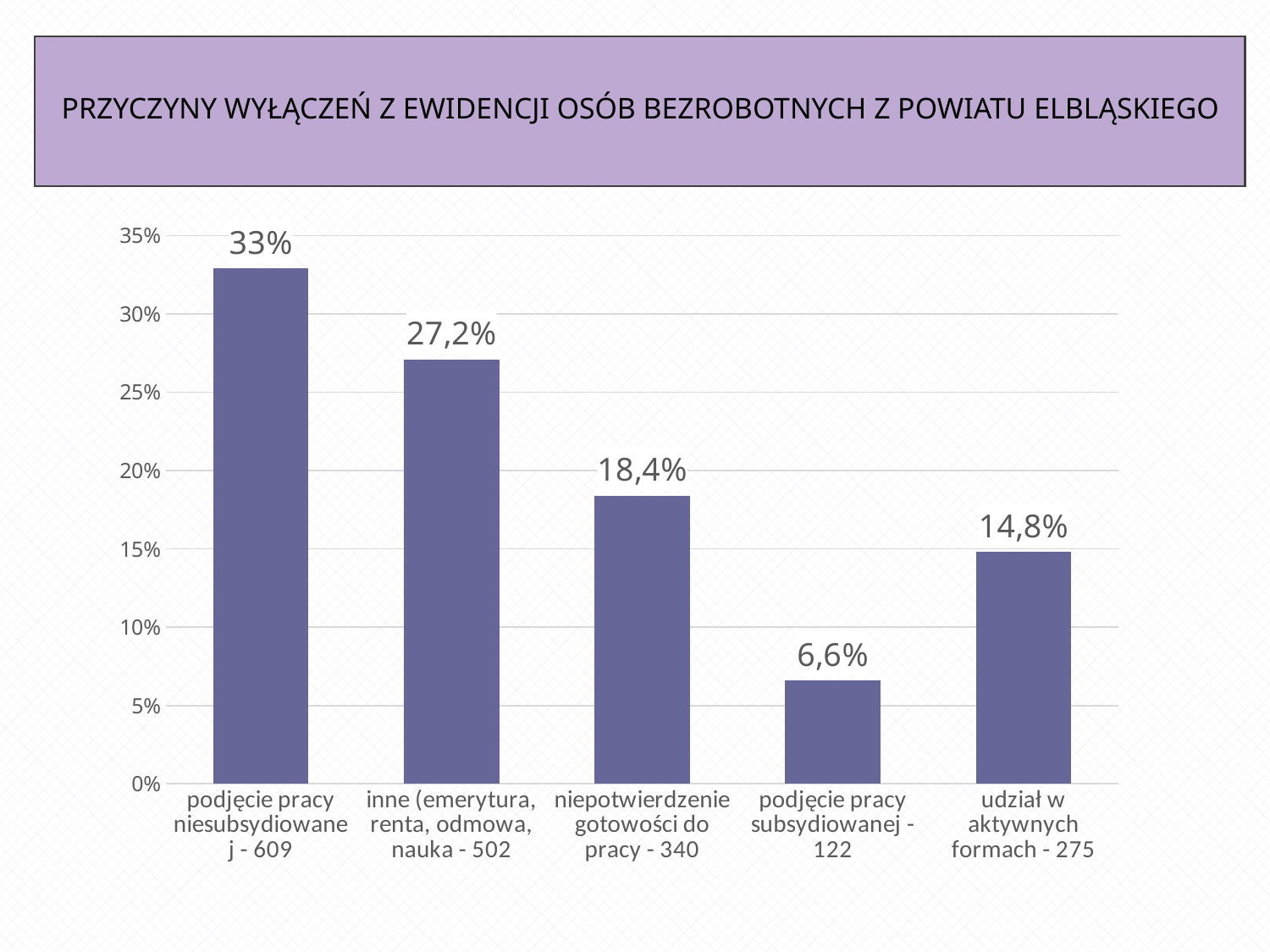
What is the title of the slide? PRZYCZYNY WYŁĄCZEŃ Z EWIDENCJI OSÓB BEZROBOTNYCH Z POWIATU ELBLĄSKIEGO What is the difference between the values for "podjęcie pracy niesubsydiowanej - 609" and "inne (emerytura, renta, odmowa, nauka - 502"? 5,8% What is the value for "podjęcie pracy subsydiowanej - 122"? 6,6% Which category has the lowest value? podjęcie pracy subsydiowanej - 122 What is the value for "niepotwierdzenie gotowości do pracy - 340"? 18,4% How many categories are shown on the chart? 5 What kind of chart is shown on the slide? bar chart Which category has the highest value? podjęcie pracy niesubsydiowanej - 609 What is the value for "inne (emerytura, renta, odmowa, nauka - 502"? 27,2% What is the value for "podjęcie pracy niesubsydiowanej - 609"? 33% Which is larger: the value for "niepotwierdzenie gotowości do pracy - 340" or the value for "udział w aktywnych formach - 275"? niepotwierdzenie gotowości do pracy - 340 What is the value for "udział w aktywnych formach - 275"? 14,8%